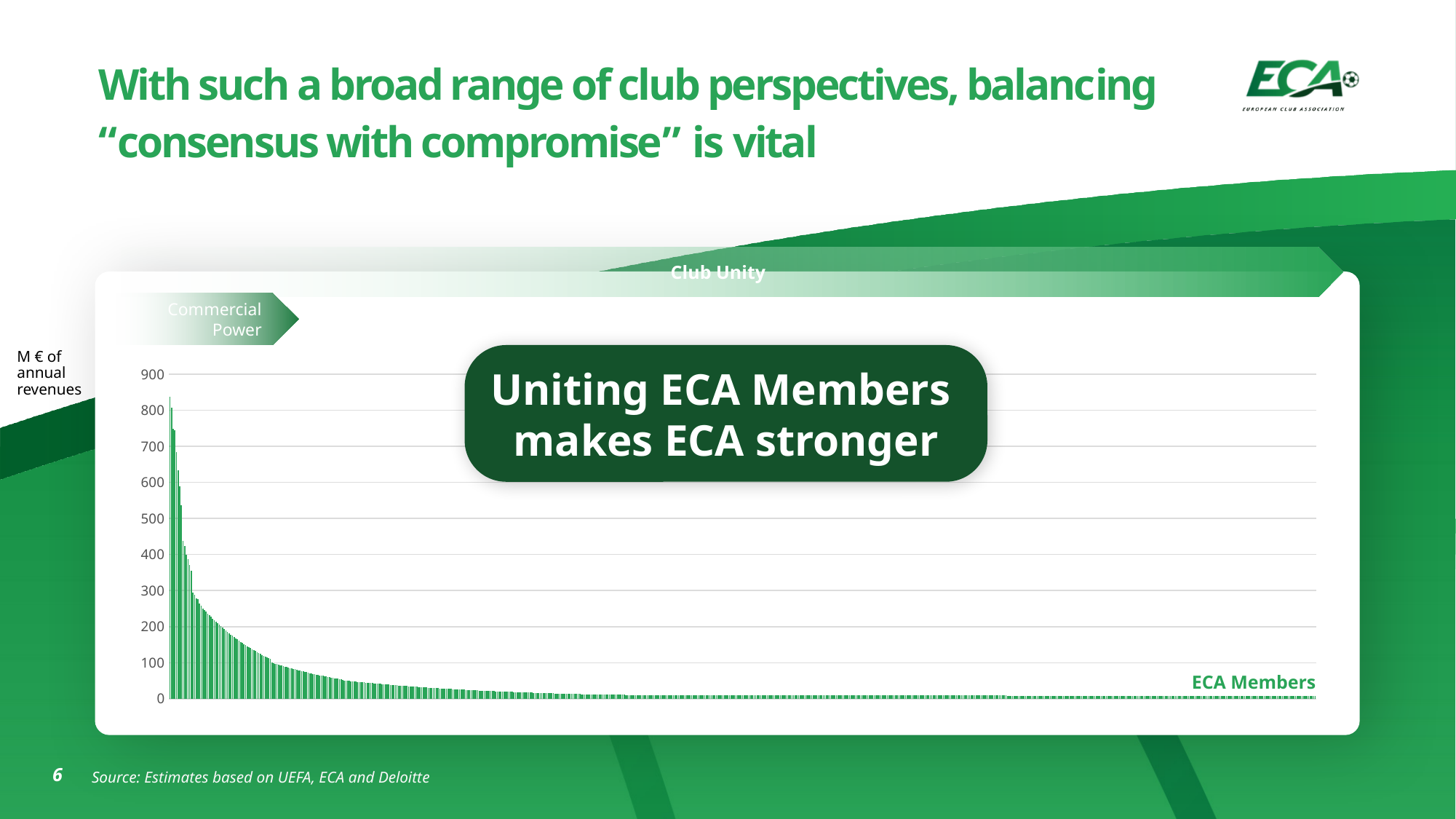
Are the values of the bars at the far right of the chart greater or less than 100? less What kind of chart is shown on the slide? bar chart What label is given to the horizontal axis of the chart? ECA Members Do the bar values rise or fall from left to right along the x axis? fall Is the value of the tallest bar greater or less than 900? less Is the value of the second-tallest bar greater or less than 600? greater What is the highest value shown on the vertical axis? 900